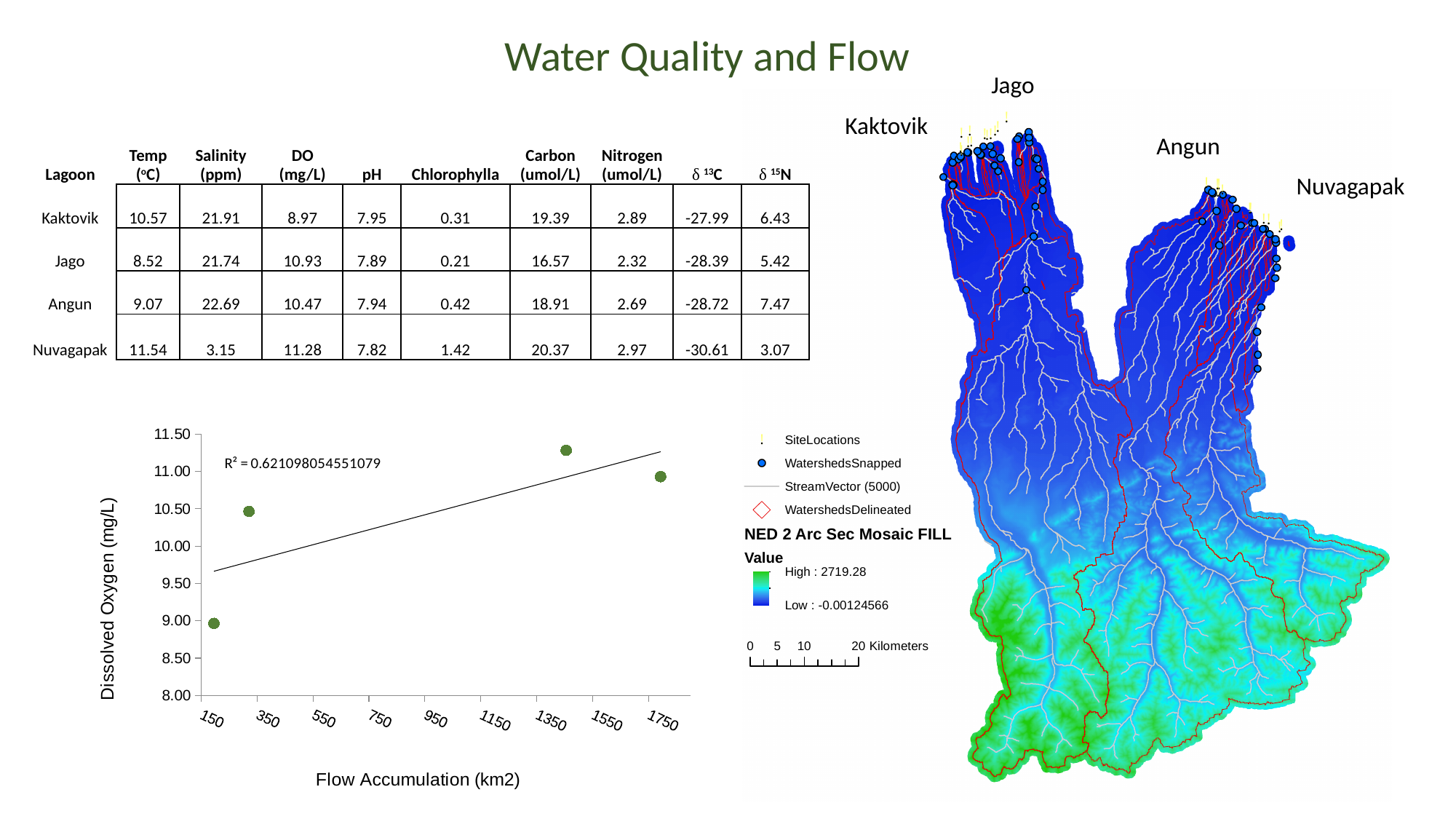
What is the R² value printed on the Dissolved Oxygen vs Flow Accumulation chart? 0.621098054551079 What is the title of the y axis of the scatter chart? Dissolved Oxygen (mg/L) What is the title of the x axis of the scatter chart? Flow Accumulation (km2) Does the trendline in the scatter chart rise or fall as flow accumulation increases? rises How many points in the scatter chart have dissolved oxygen above 10.00 mg/L? 3 In the scatter chart, is the dissolved oxygen of the highest point greater or less than 11.00? greater In the scatter chart, is the dissolved oxygen of the point at the far right (near 1750 km2) greater or less than 10.50? greater How many data points are plotted in the Dissolved Oxygen vs Flow Accumulation chart? 4 In the scatter chart, is the dissolved oxygen of the point at the far left (near 150 km2) greater or less than 9.50? less In the scatter chart, which has the higher dissolved oxygen: the point near 1350 km2 or the point near 1750 km2? the point near 1350 km2 What kind of chart is shown at the bottom left of the slide? scatter chart